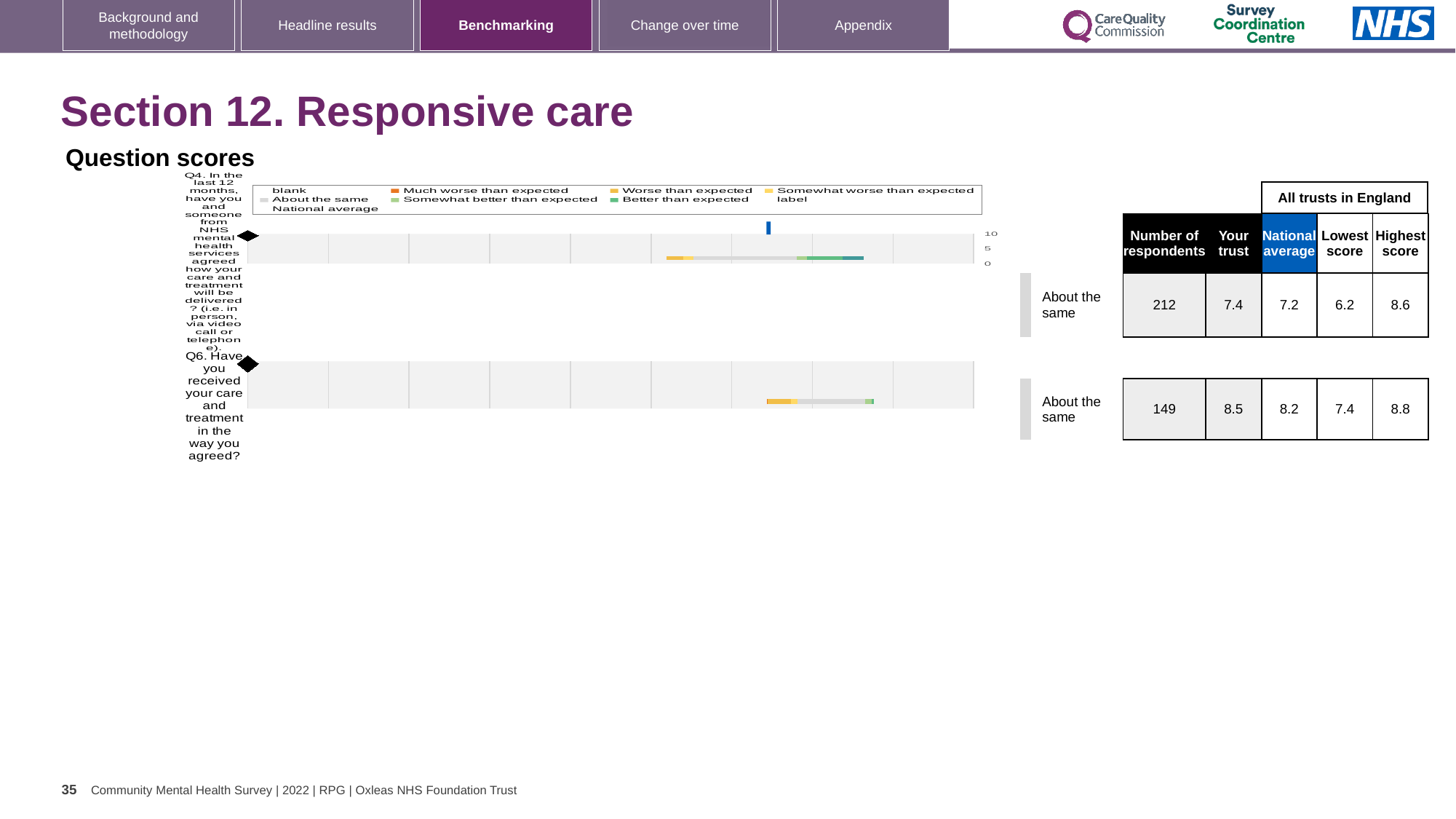
What is the highest score among all trusts in England for Q6? 8.8 What kind of chart is used to show the question scores on this slide? bar chart How is the trust's result for Q4 categorised relative to other trusts? About the same What is the maximum value shown on the chart's score axis? 10 What is the lowest score among all trusts in England for Q4? 6.2 How many respondents answered Q4? 212 What is the difference between the trust's score and the national average for Q6? 0.3 What is the 'Your trust' score for Q4 (agreed how your care and treatment will be delivered)? 7.4 What is the difference between the highest and lowest scores for Q4 across all trusts in England? 2.4 Which question has the higher 'Your trust' score, Q4 or Q6? Q6 What is the national average score for Q6 (received your care and treatment in the way you agreed)? 8.2 How many questions (categories) are plotted in the question scores chart? 2